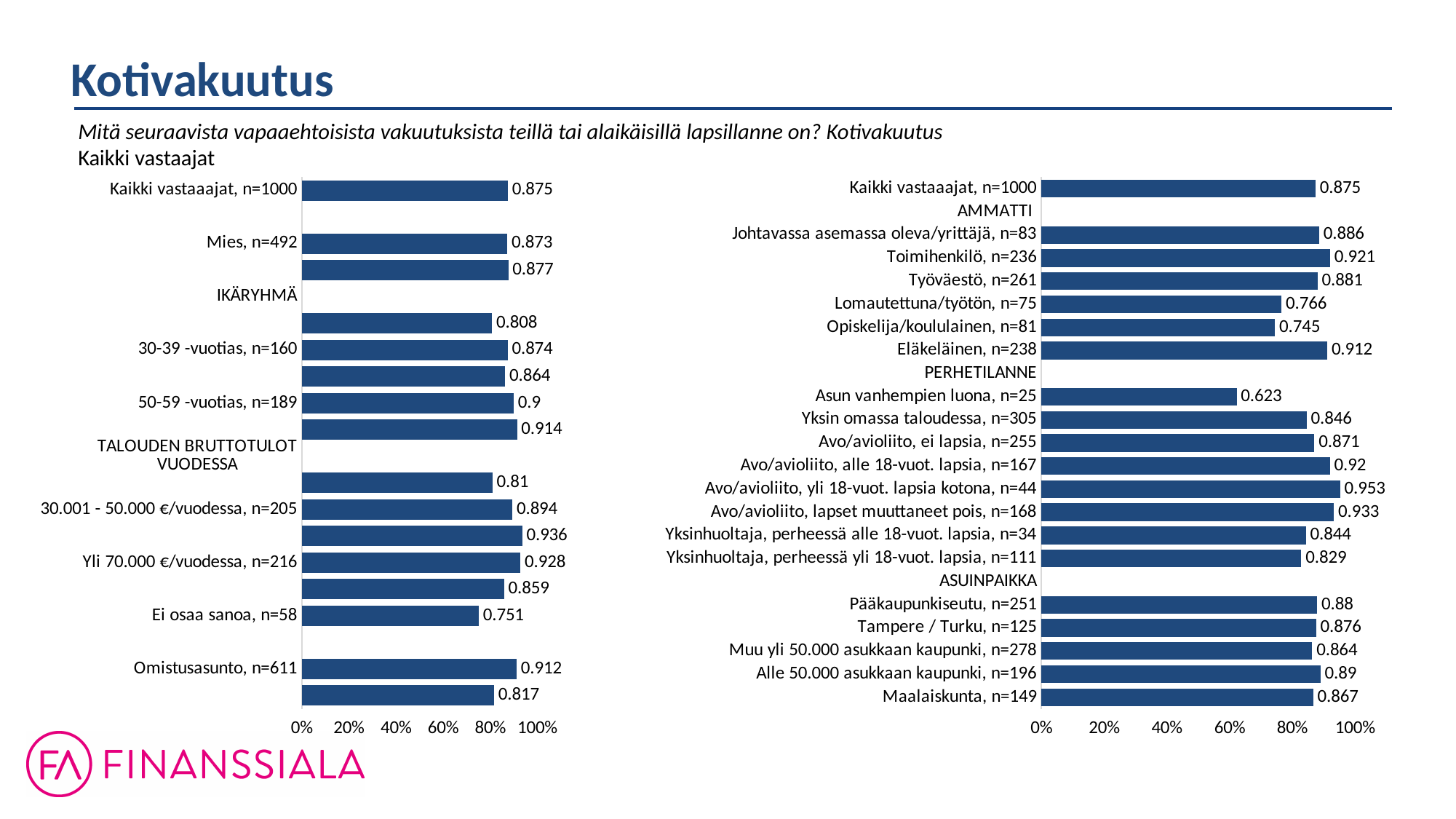
In the right-hand chart, is the value for Lomautettuna/työtön, n=75 greater or less than 80%? less What kind of chart is the left-hand chart? bar chart In the left-hand chart, which is larger: the value for Yli 70.000 €/vuodessa, n=216 or the value for 30.001 - 50.000 €/vuodessa, n=205? Yli 70.000 €/vuodessa, n=216 In the right-hand chart, what is the value for Toimihenkilö, n=236? 0.921 In the right-hand chart, what is the difference between the values for Eläkeläinen, n=238 and Opiskelija/koululainen, n=81? 0.167 In the right-hand chart, which category has the lowest value? Asun vanhempien luona, n=25 In the left-hand chart, what is the value for Ei osaa sanoa, n=58? 0.751 In the right-hand chart, which category has the highest value? Avo/avioliito, yli 18-vuot. lapsia kotona, n=44 In the left-hand chart, what is the difference between the values for 50-59 -vuotias, n=189 and 30-39 -vuotias, n=160? 0.026 In the left-hand chart, what is the value for Omistusasunto, n=611? 0.912 In the right-hand chart, what is the value for Maalaiskunta, n=149? 0.867 In the right-hand chart, what is the value for Asun vanhempien luona, n=25? 0.623